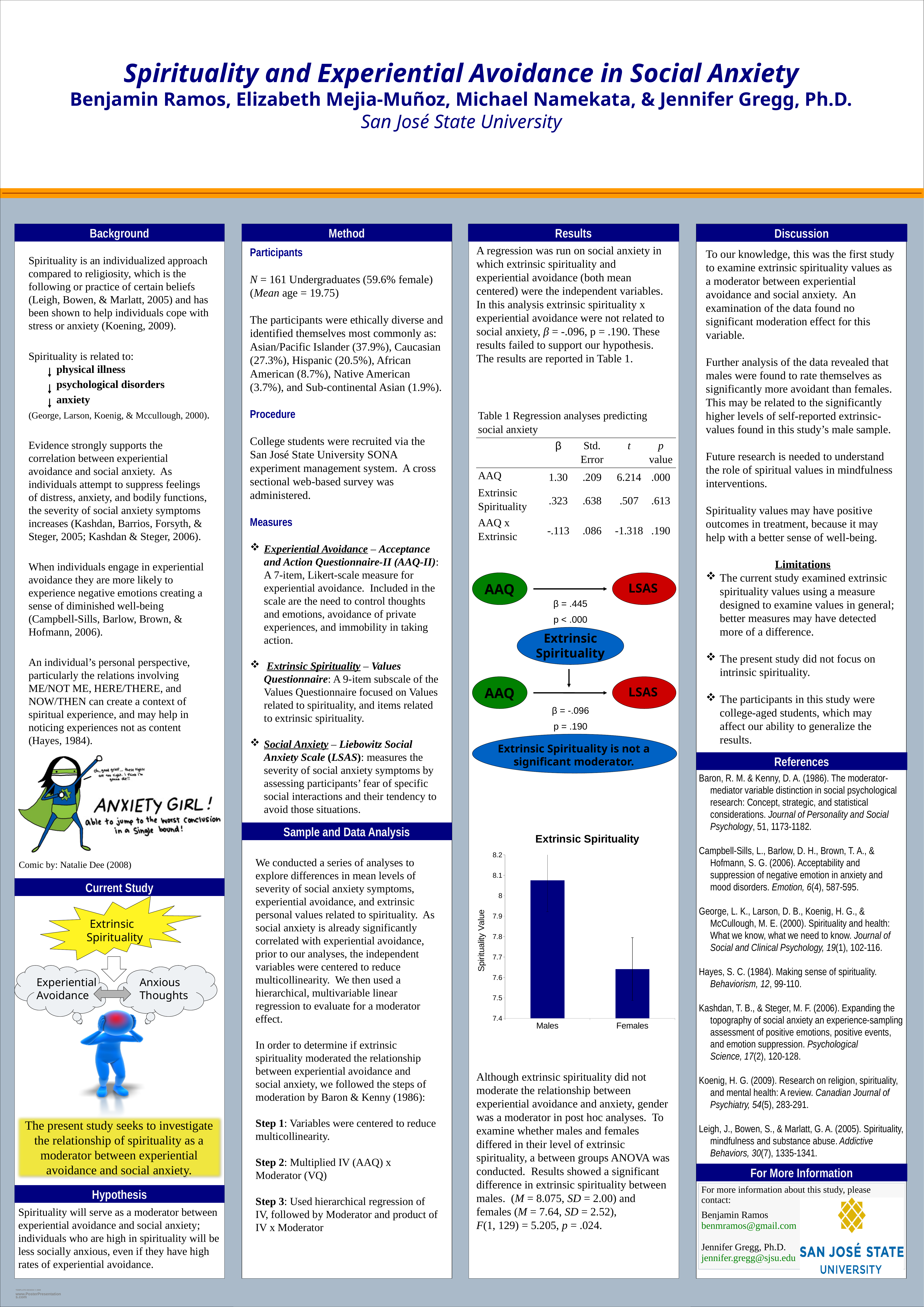
What is the title of the bar chart in the Results column? Extrinsic Spirituality In the "Extrinsic Spirituality" chart, is the value for Males or Females larger? Males In the "Extrinsic Spirituality" chart, is the value for Females greater or less than 7.7? less In the "Extrinsic Spirituality" chart, is the value for Females greater or less than 7.8? less In the "Extrinsic Spirituality" chart, is the value for Males greater or less than 8? greater Which category has the highest value in the "Extrinsic Spirituality" chart? Males What kind of chart is the "Extrinsic Spirituality" chart? bar chart How many categories are shown on the x axis of the "Extrinsic Spirituality" chart? 2 What is the y-axis label of the "Extrinsic Spirituality" chart? Spirituality Value Which category has the lowest value in the "Extrinsic Spirituality" chart? Females Do the values in the "Extrinsic Spirituality" chart rise or fall from Males to Females? fall